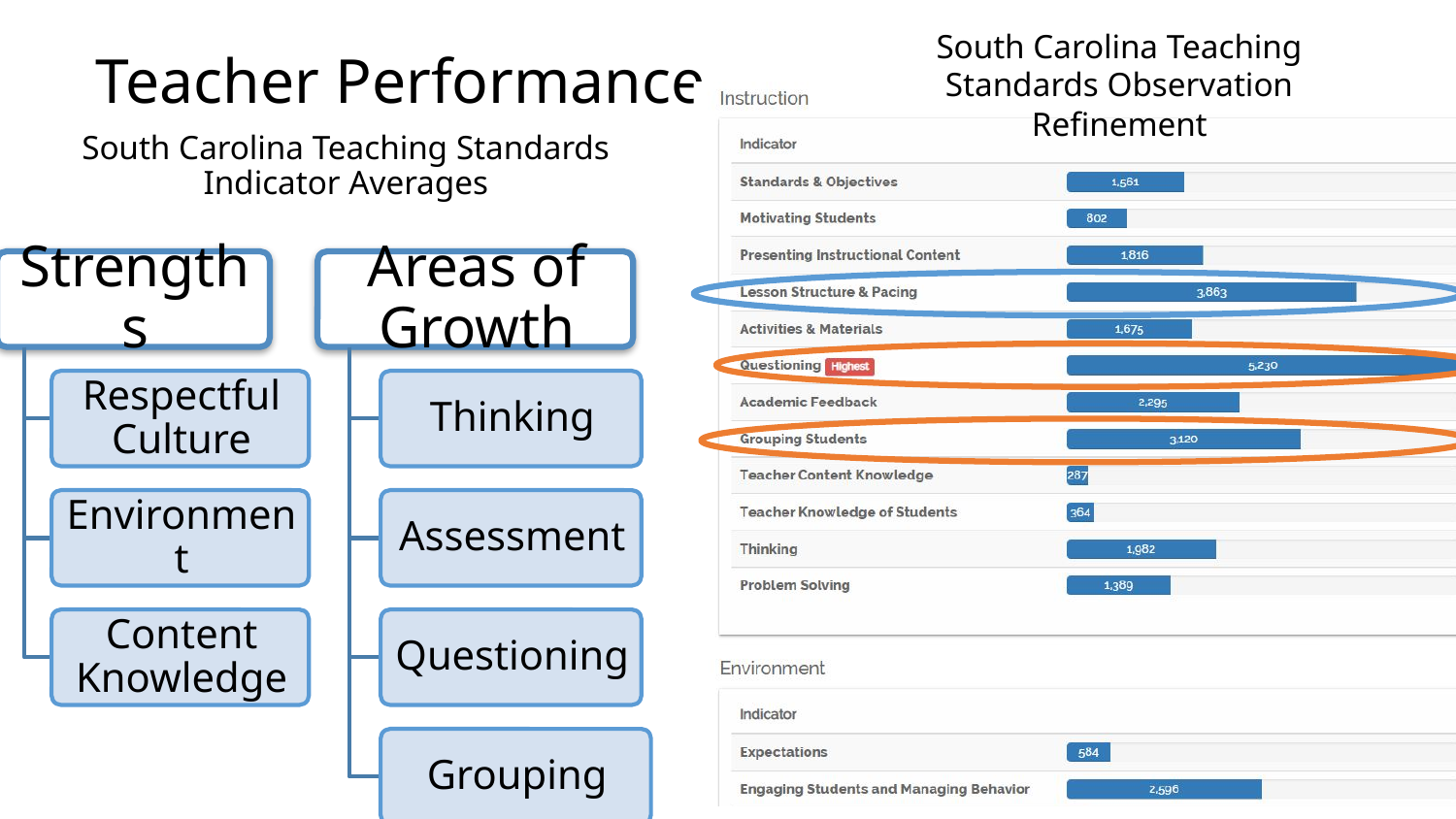
How many indicators are listed in the Instruction chart? 12 In the Instruction chart, which indicator is tagged with the label "Highest"? Questioning In the Environment chart, what is the value for Engaging Students and Managing Behavior? 2,596 In the Instruction chart, which is larger, the value for Academic Feedback or the value for Thinking? Academic Feedback In the Instruction chart, which indicator has the lowest value? Teacher Content Knowledge In the Instruction chart, what is the value for Questioning? 5,230 In the Instruction chart, what is the difference between the values for Questioning and Grouping Students? 2,110 In the Instruction chart, what is the value for Grouping Students? 3,120 What kind of chart is the Instruction chart? Bar chart In the Instruction chart, what is the value for Lesson Structure & Pacing? 3,863 In the Instruction chart, which indicator has the highest value? Questioning In the Environment chart, what is the value for Expectations? 584